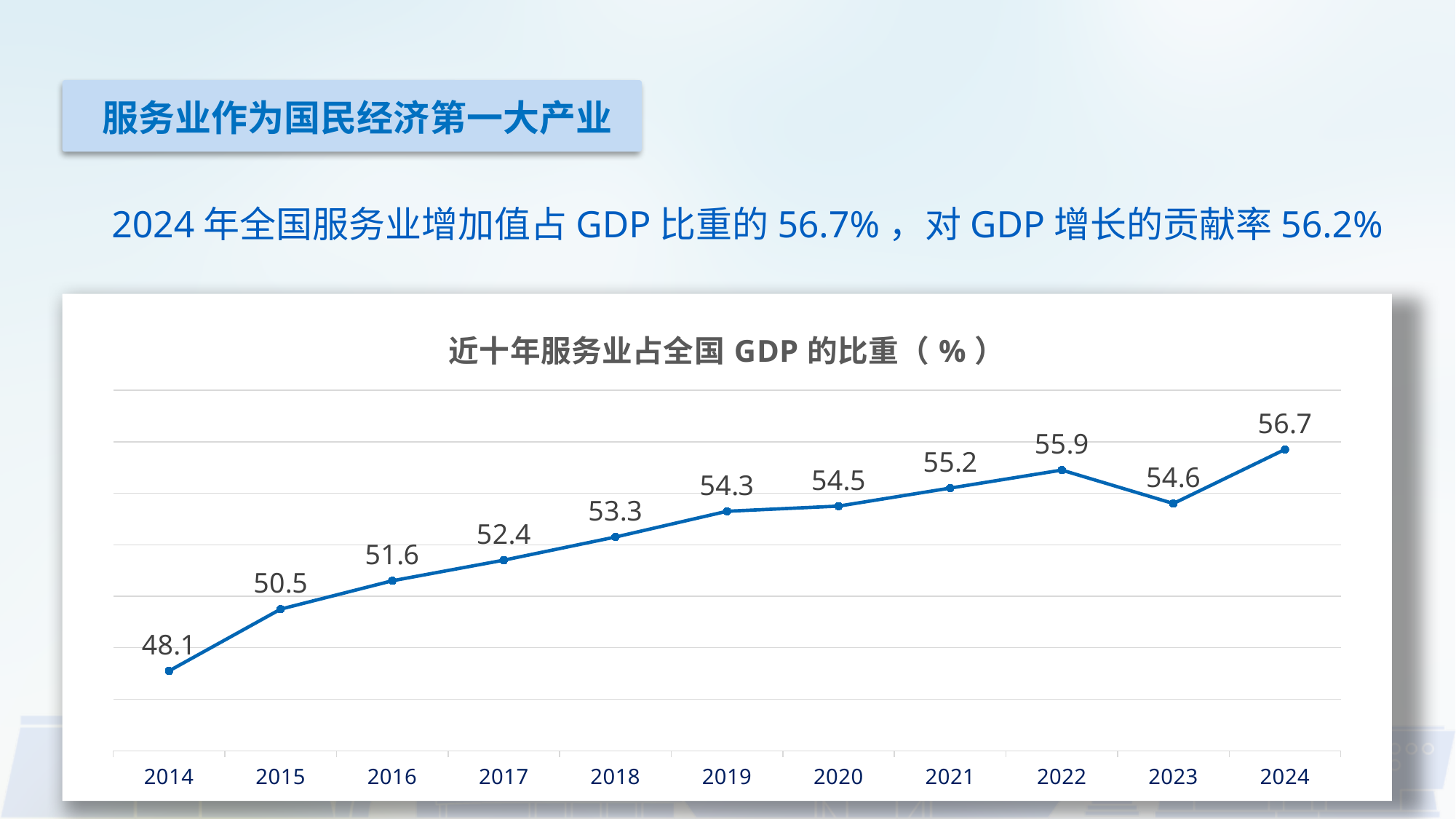
What kind of chart is shown? Line chart How many years are plotted on the chart? 11 Which is larger, the value for 2021 or the value for 2023? 2021 What is the difference between the values for 2022 and 2023? 1.3 Which year has the lowest value? 2014 Do the values generally rise or fall from 2014 to 2024? Rise What is the value for 2023? 54.6 Which year has the highest value? 2024 What is the difference between the values for 2024 and 2014? 8.6 What is the value for 2014? 48.1 What is the title of the chart? 近十年服务业占全国 GDP 的比重（%） What is the value for 2019? 54.3